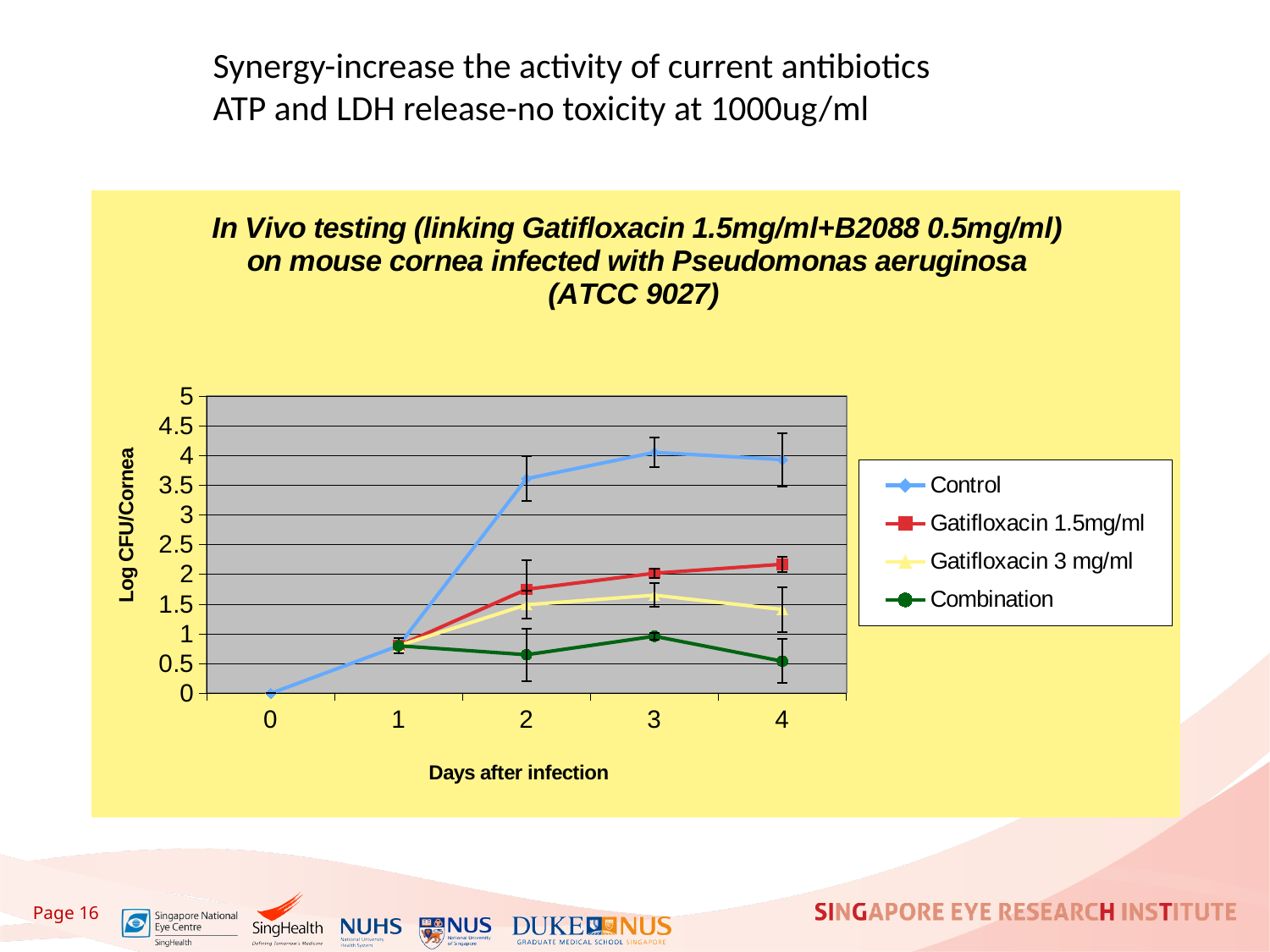
What is the label of the y axis? Log CFU/Cornea What kind of chart is shown on the slide? line chart Is the value for Gatifloxacin 3 mg/ml at day 4 greater or less than 2? less How many series does the legend list? 4 How many days after infection are marked on the x axis? 5 Which series has the highest value at day 4? Control At day 4, which is larger: Gatifloxacin 1.5mg/ml or Gatifloxacin 3 mg/ml? Gatifloxacin 1.5mg/ml What is the label of the x axis? Days after infection Does the Control series rise or fall from day 0 to day 3? rise Which series has the lowest value at day 4? Combination Is the value for Control at day 3 greater or less than 3.5? greater Is the value for Combination at day 4 greater or less than 1? less